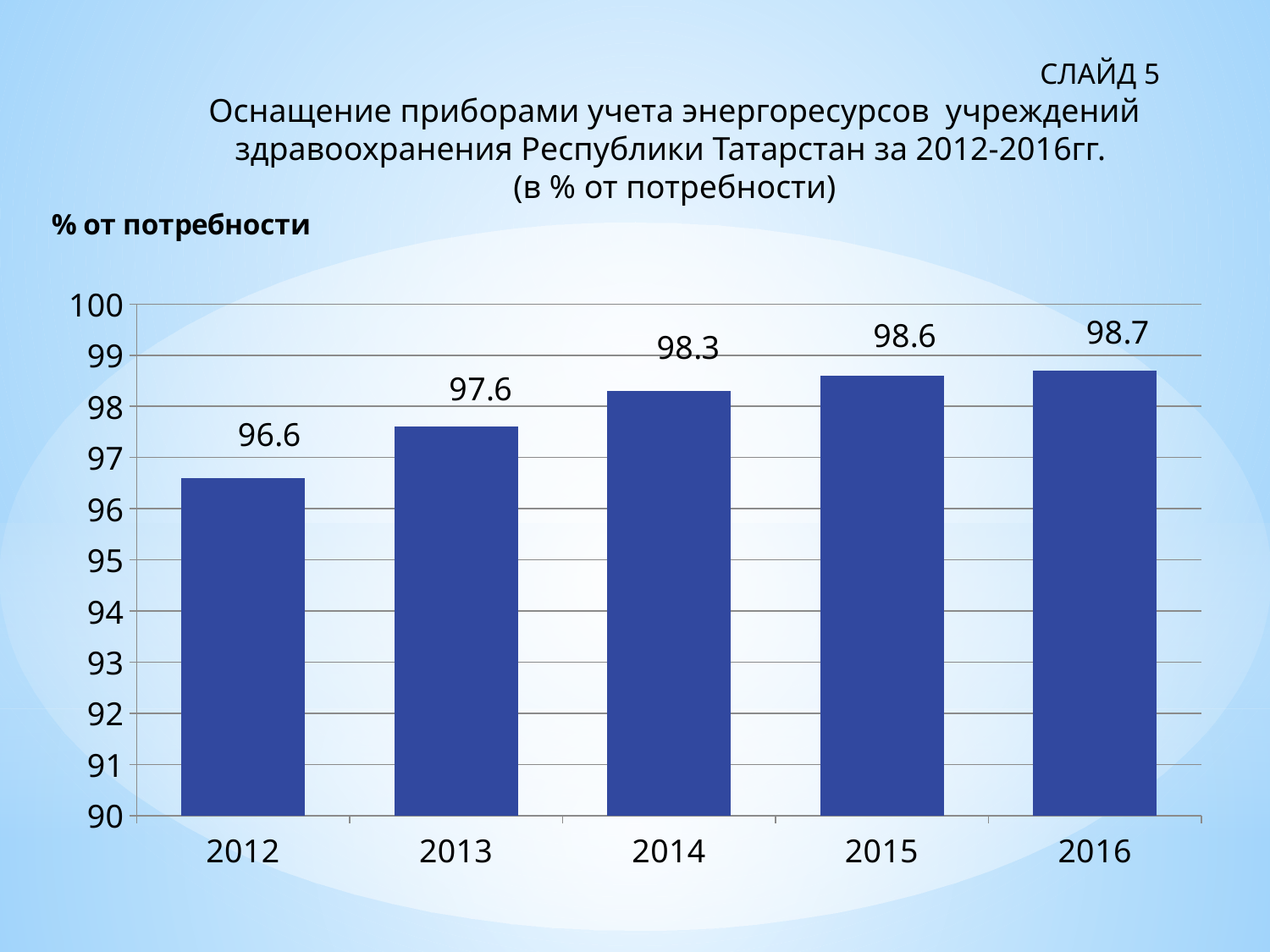
What is the value for 2014? 98.3 What is the value for 2012? 96.6 Is the value for 2012 greater or less than 97? less Which year has the highest value? 2016 How many years are shown on the x axis? 5 What is the value for 2016? 98.7 Do the values rise or fall from 2012 to 2016? rise Which is larger, the value for 2013 or the value for 2015? 2015 What is the difference between the values for 2013 and 2012? 1.0 What is the difference between the values for 2016 and 2014? 0.4 What kind of chart is shown on the slide? bar chart Which year has the lowest value? 2012